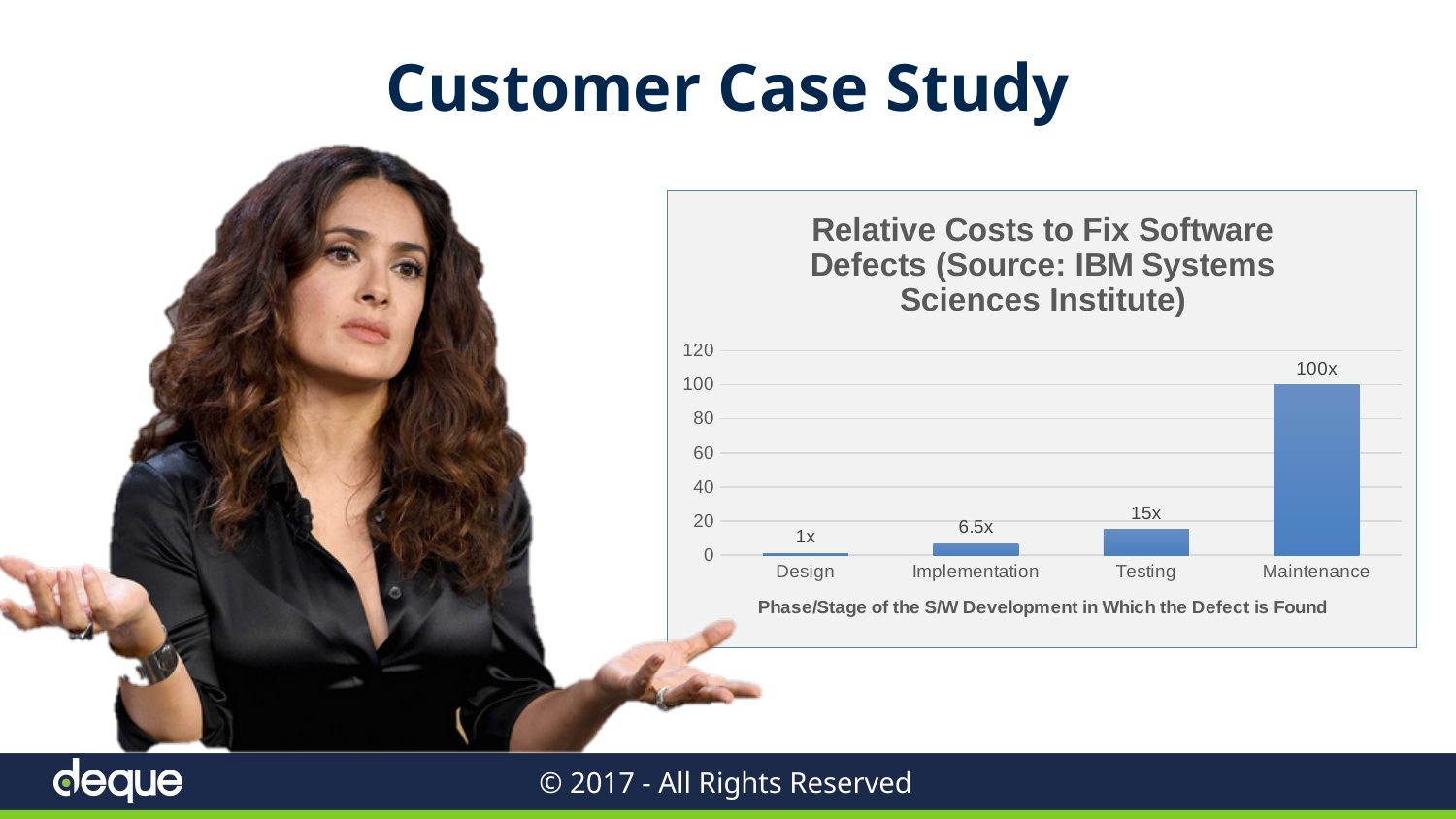
Which phase has the lowest relative cost to fix a defect? Design Do the values rise or fall from Design to Maintenance along the x axis? Rise What kind of chart is shown on the slide? Bar chart Which phase has the highest relative cost to fix a defect? Maintenance Which has a higher relative cost to fix a defect, Implementation or Testing? Testing What is the relative cost to fix a defect found in the Testing phase? 15x What is the relative cost to fix a defect found in the Maintenance phase? 100x Is the value for Maintenance greater or less than 80? greater What is the relative cost to fix a defect found in the Design phase? 1x How many phases are shown on the x axis of the chart? 4 How much greater is the relative cost for Maintenance than for Testing? 85x What is the relative cost to fix a defect found in the Implementation phase? 6.5x